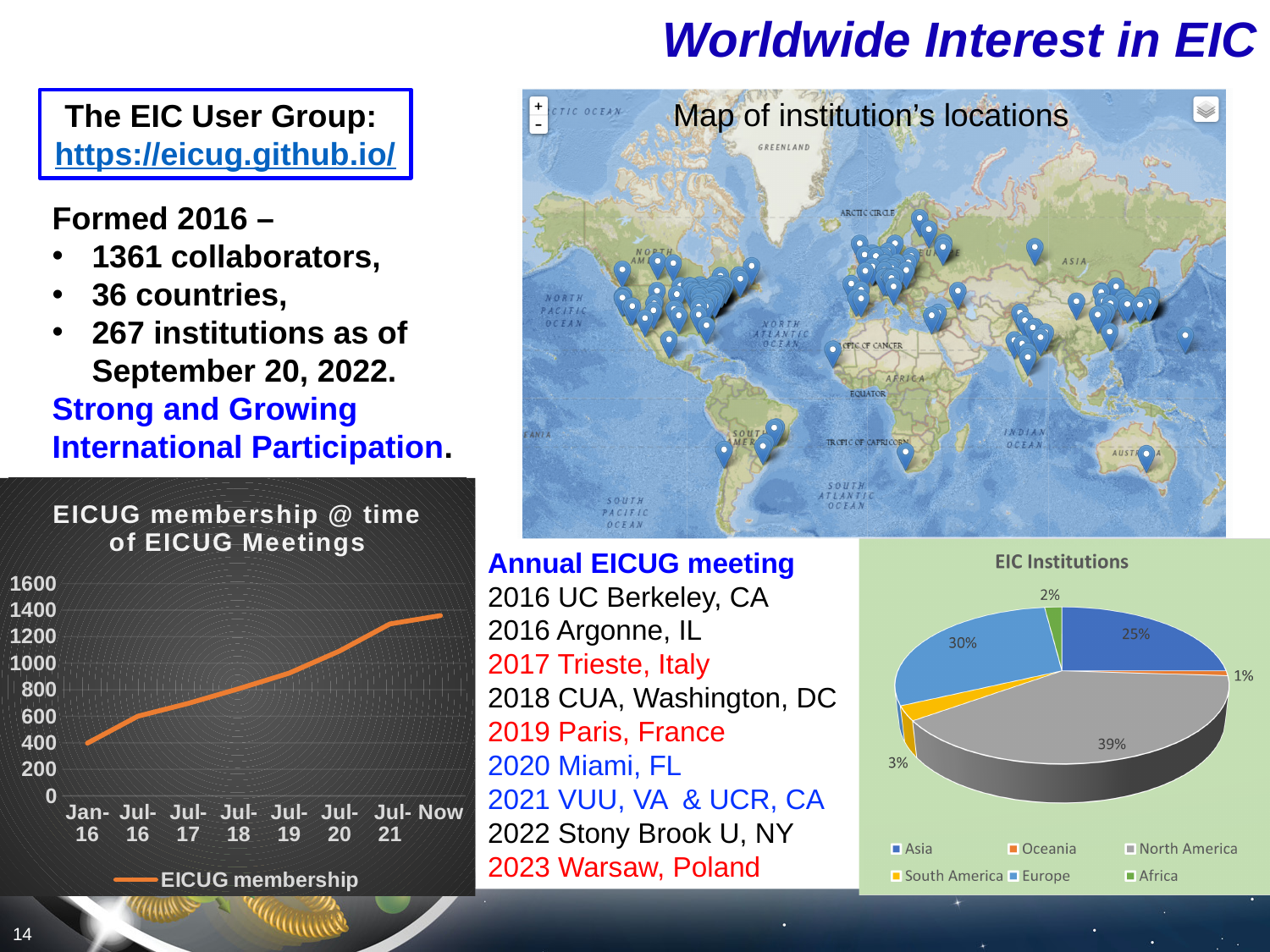
On the 'EICUG membership @ time of EICUG Meetings' chart, do the values rise or fall from Jan-16 to Now? rise What kind of chart is the 'EICUG membership @ time of EICUG Meetings' chart? line chart How many regions does the legend of the 'EIC Institutions' pie chart list? 6 On the 'EIC Institutions' pie chart, which is larger, Asia or Europe? Europe On the 'EIC Institutions' pie chart, what share is North America? 39% On the 'EIC Institutions' pie chart, which region has the smallest share? Oceania On the 'EIC Institutions' pie chart, what share is Europe? 30% On the 'EICUG membership @ time of EICUG Meetings' chart, is the value for Jan-16 greater or less than 600? less How many points are plotted on the 'EICUG membership @ time of EICUG Meetings' chart? 8 What kind of chart is the 'EIC Institutions' chart? pie chart On the 'EICUG membership @ time of EICUG Meetings' chart, is the value for Jul-20 greater or less than 1000? greater On the 'EICUG membership @ time of EICUG Meetings' chart, is the value for Now greater or less than 1200? greater